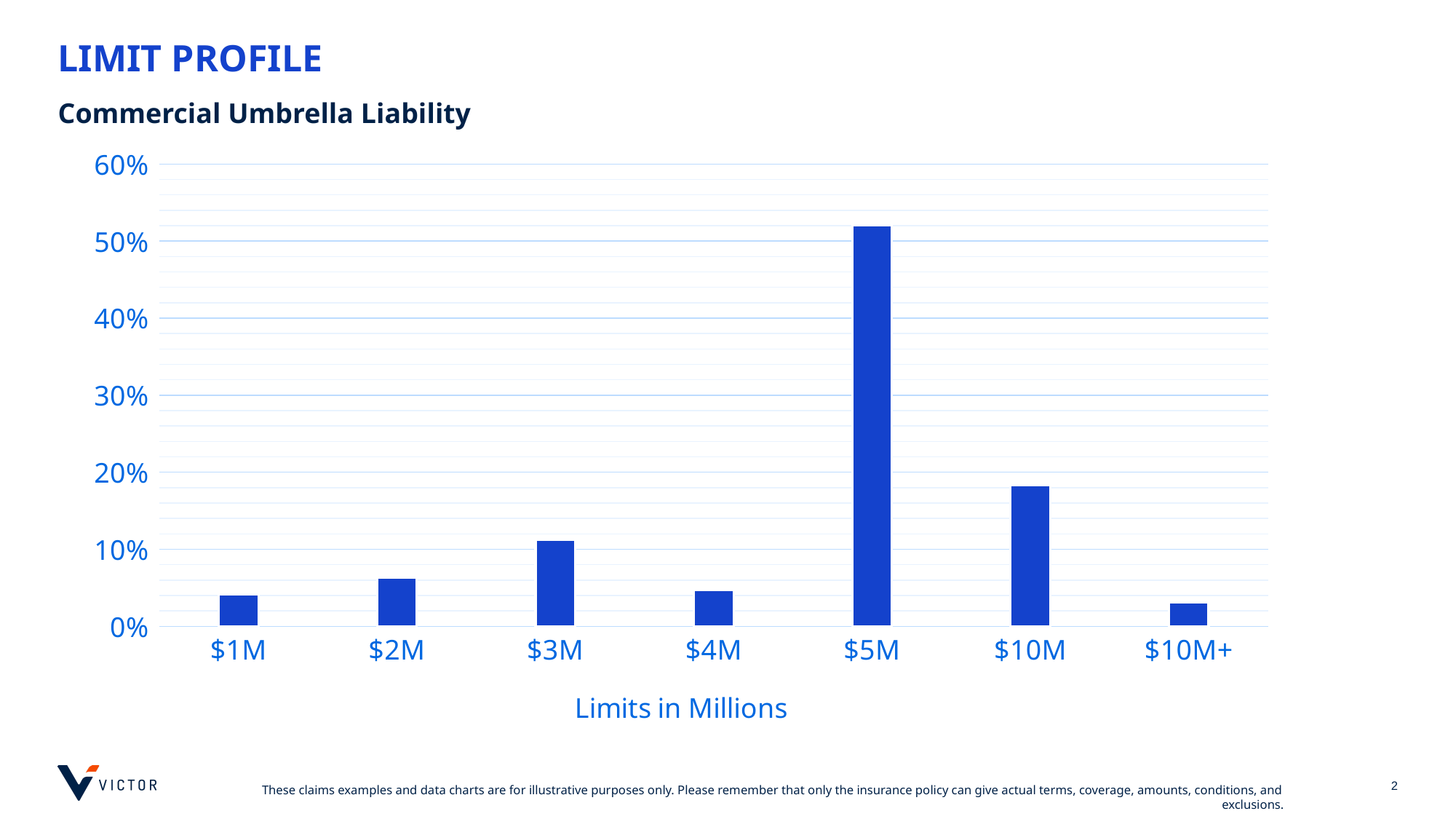
Is the value for $10M+ greater or less than 10%? less Which limit category has the highest percentage? $5M Which is larger, the value for $3M or the value for $2M? $3M Is the value for $3M greater or less than 10%? greater How many limit categories are shown on the x axis? 7 Is the value for $5M greater or less than 50%? greater Which is larger, the value for $10M or the value for $3M? $10M What is the x-axis title of the chart? Limits in Millions What kind of chart is shown on the slide? bar chart